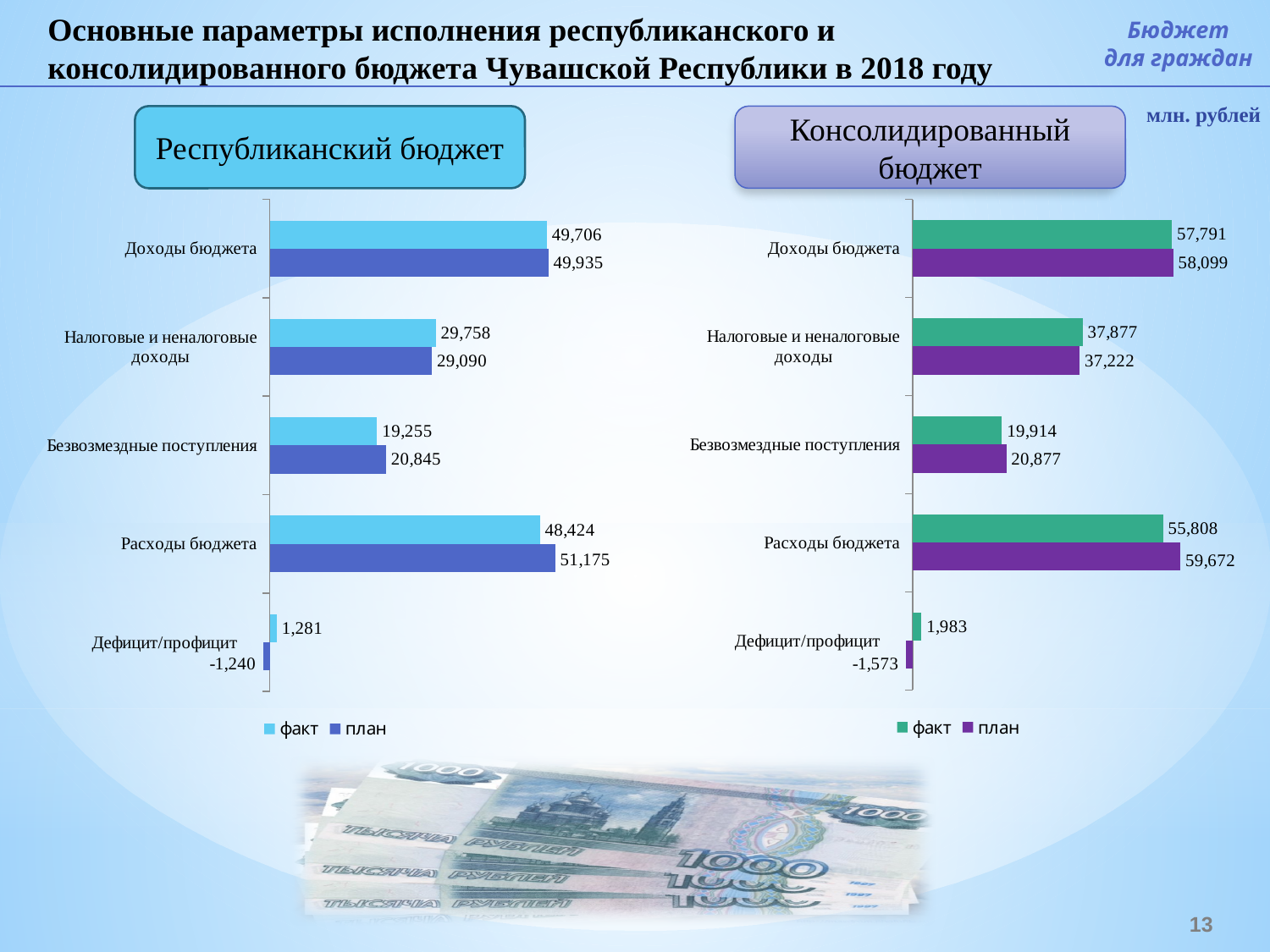
What type of chart is the 'Консолидированный бюджет' chart? Bar chart In the 'Консолидированный бюджет' chart, what is the difference between the 'план' and 'факт' values for 'Безвозмездные поступления'? 963 In the 'Консолидированный бюджет' chart, what is the 'факт' value for 'Налоговые и неналоговые доходы'? 37,877 In the 'Республиканский бюджет' chart, which category has the lowest 'факт' value? Дефицит/профицит In the 'Республиканский бюджет' chart, what is the 'план' value for 'Расходы бюджета'? 51,175 How many series does the legend of the 'Республиканский бюджет' chart list? 2 In the 'Консолидированный бюджет' chart, which category has the highest 'план' value? Расходы бюджета In the 'Республиканский бюджет' chart, which is larger for 'Налоговые и неналоговые доходы': the 'факт' value or the 'план' value? факт How many categories are shown in the 'Консолидированный бюджет' chart? 5 In the 'Консолидированный бюджет' chart, what is the 'план' value for 'Дефицит/профицит'? -1,573 In the 'Республиканский бюджет' chart, what is the 'факт' value for 'Доходы бюджета'? 49,706 In the 'Республиканский бюджет' chart, what is the difference between the 'план' and 'факт' values for 'Расходы бюджета'? 2,751